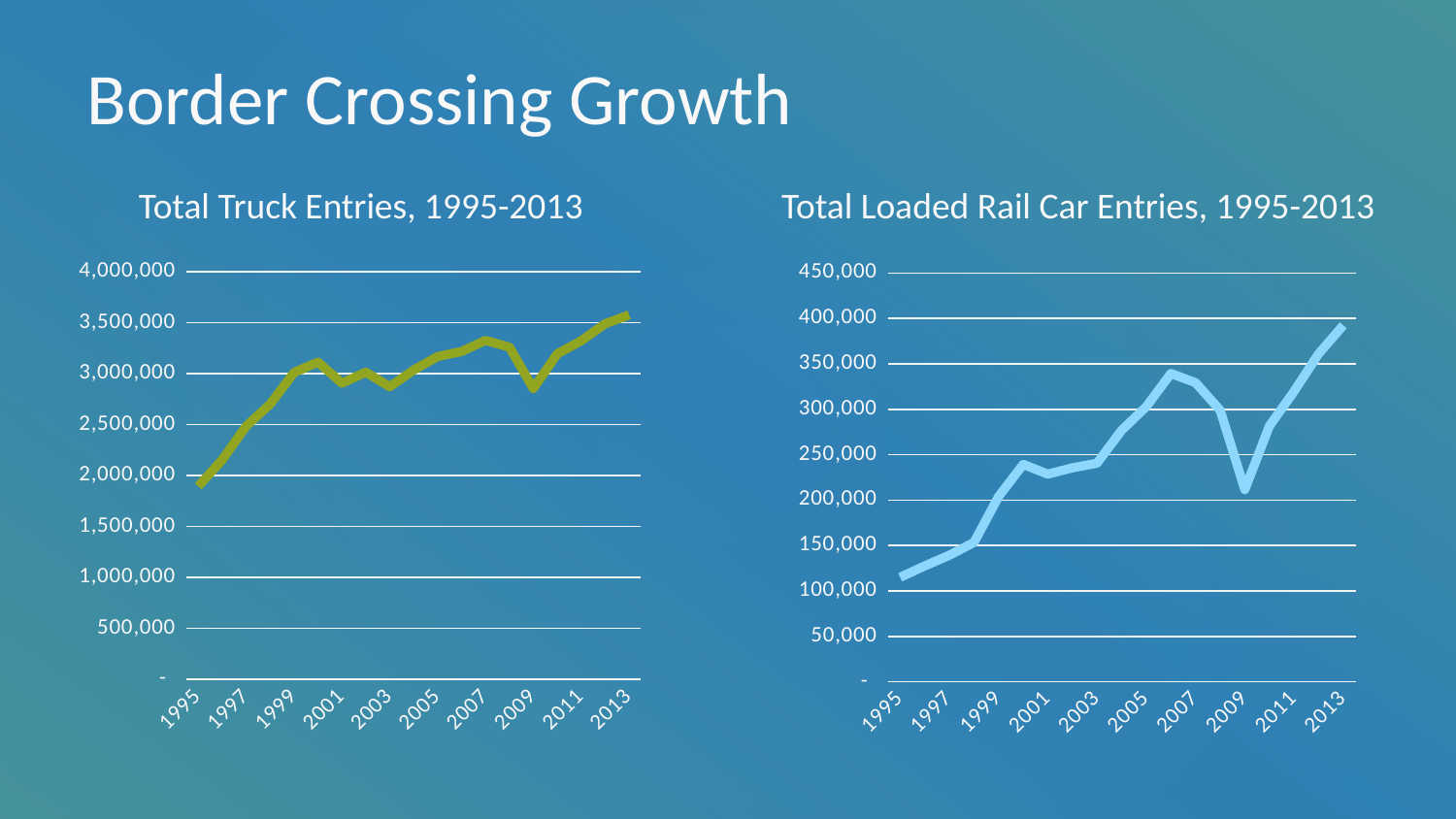
In the Total Truck Entries, 1995-2013 chart, is the value for 2009 greater or less than 3,000,000? less In the Total Loaded Rail Car Entries, 1995-2013 chart, which is larger, the value for 2007 or the value for 2009? 2007 In the Total Truck Entries, 1995-2013 chart, is the value for 2007 greater or less than 3,000,000? greater What kind of chart is the Total Truck Entries, 1995-2013 chart? line chart In the Total Loaded Rail Car Entries, 1995-2013 chart, which year has the lowest value? 1995 What is the highest value shown on the vertical axis of the Total Loaded Rail Car Entries, 1995-2013 chart? 450,000 In the Total Truck Entries, 1995-2013 chart, which year has the lowest value? 1995 What kind of chart is the Total Loaded Rail Car Entries, 1995-2013 chart? line chart In the Total Loaded Rail Car Entries, 1995-2013 chart, do the values overall rise or fall from 1995 to 2013? rise In the Total Truck Entries, 1995-2013 chart, do the values overall rise or fall from 1995 to 2013? rise In the Total Loaded Rail Car Entries, 1995-2013 chart, is the value for 1995 greater or less than 100,000? greater In the Total Loaded Rail Car Entries, 1995-2013 chart, which year has the highest value? 2013